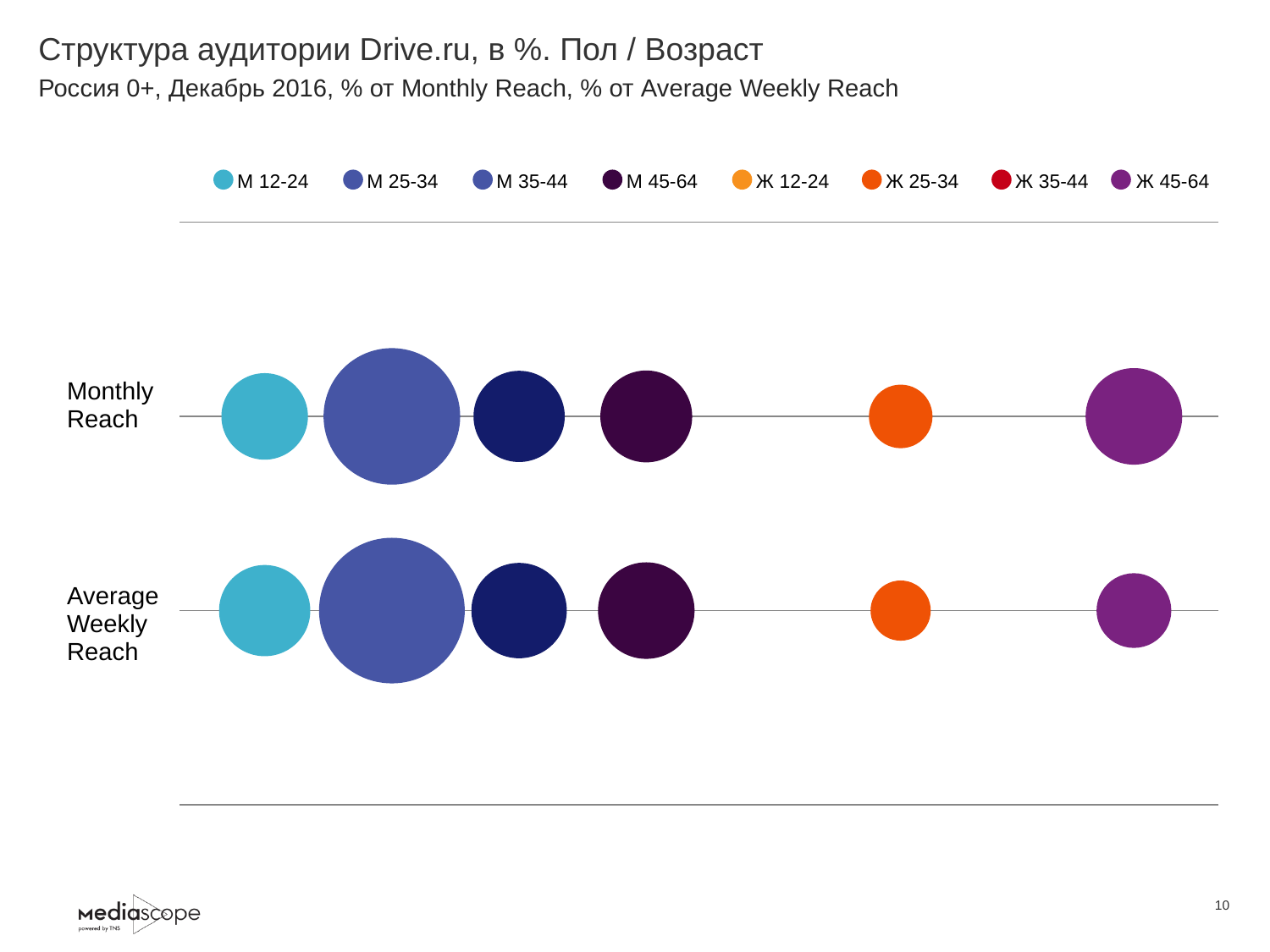
Which series has the largest bubble in the Monthly Reach row? М 25-34 In the Monthly Reach row, which bubble is larger: М 25-34 or Ж 25-34? М 25-34 Which series has the smallest visible bubble in the Monthly Reach row? Ж 25-34 How many series does the legend list? 8 What is the title of the slide? Структура аудитории Drive.ru, в %. Пол / Возраст Which bubble is larger for Ж 45-64: Monthly Reach or Average Weekly Reach? Monthly Reach Which series has the largest bubble in the Average Weekly Reach row? М 25-34 What are the two row labels on the chart? Monthly Reach; Average Weekly Reach How many rows (categories) are plotted on the chart? 2 In the Average Weekly Reach row, which bubble is larger: М 12-24 or Ж 25-34? М 12-24 What kind of chart is shown on the slide? Bubble chart